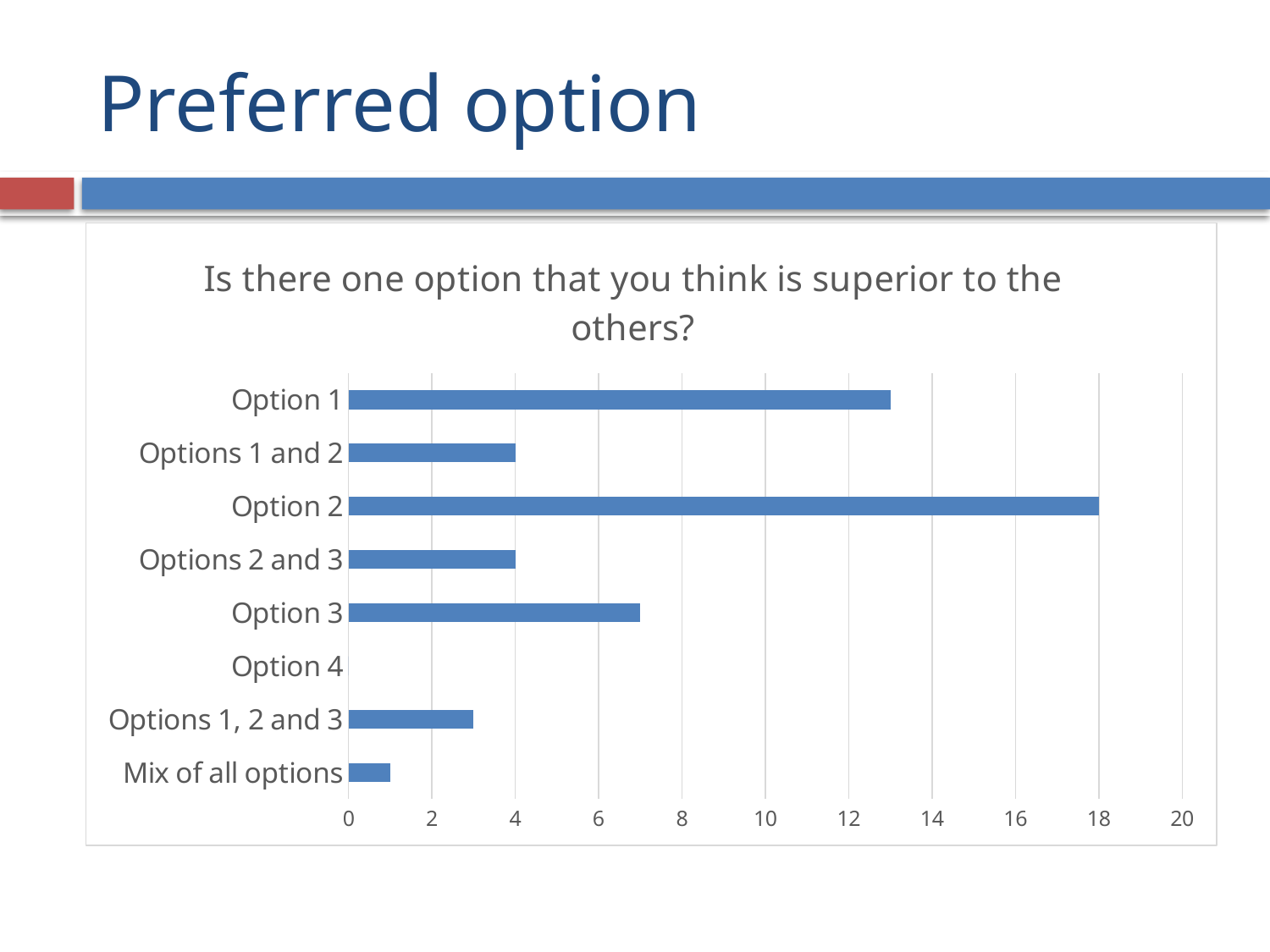
Is the value for Option 3 greater or less than 8? less What is the value for Option 4? 0 What is the value for Option 2? 18 Which category has the highest value? Option 2 What is the title of the chart? Is there one option that you think is superior to the others? What type of chart is shown on the slide? bar chart Which category has the lowest value? Option 4 Which has a larger value, Option 1 or Option 3? Option 1 What is the difference between the values for Option 2 and Options 2 and 3? 14 Is the value for Option 1 greater or less than 12? greater How many categories are shown on the chart? 8 What is the value for Options 1 and 2? 4